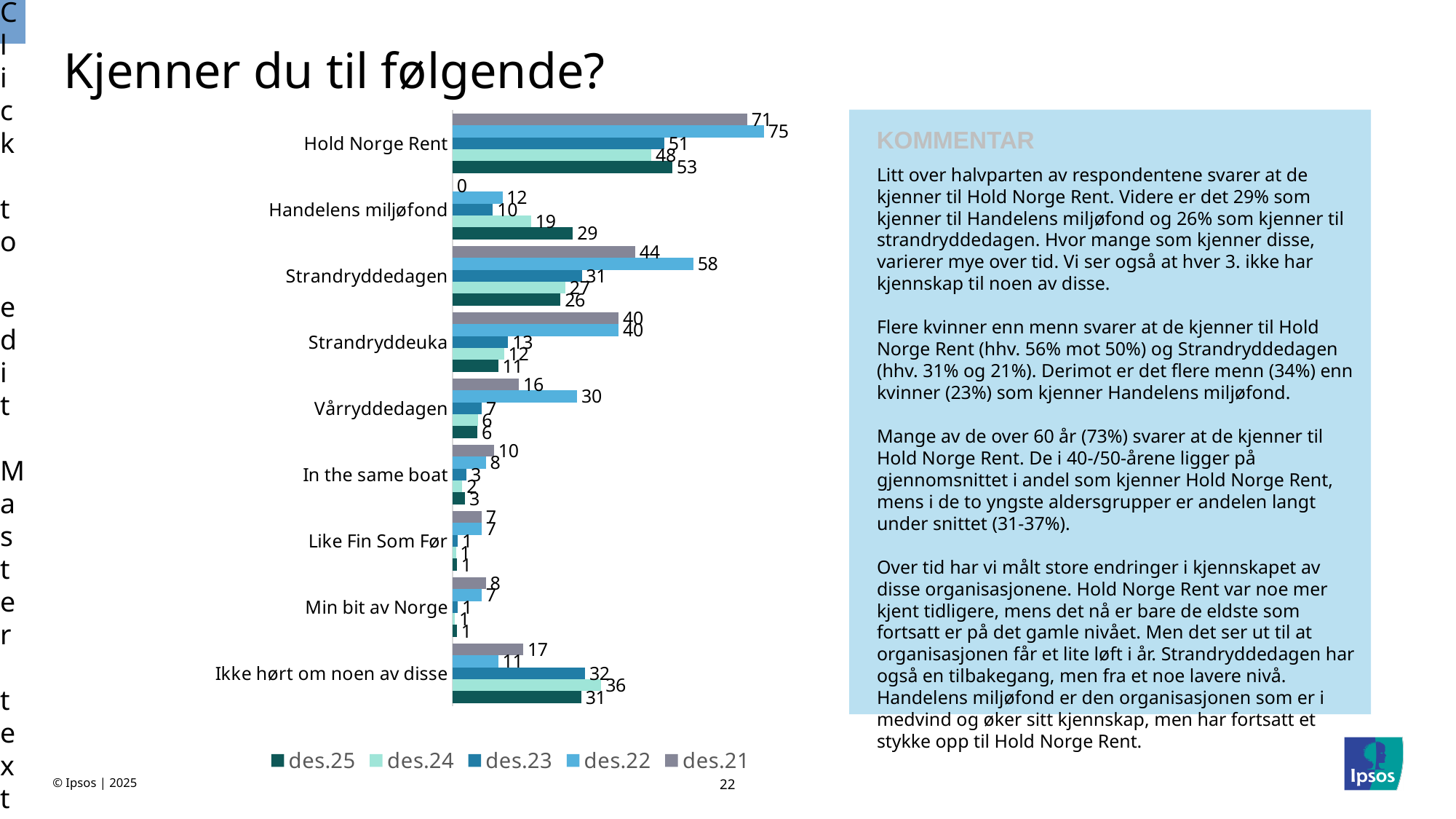
Which is larger for Strandryddedagen: the des.21 value or the des.23 value? des.21 What is the title of the slide? Kjenner du til følgende? Which category has the highest des.25 value? Hold Norge Rent How many series does the legend list? 5 What is the des.22 value for Strandryddedagen? 58 How many categories are shown on the chart? 9 What is the des.25 value for Handelens miljøfond? 29 What is the difference between the des.22 and des.25 values for Hold Norge Rent? 22 What kind of chart is shown on the slide? bar chart What is the des.24 value for Ikke hørt om noen av disse? 36 What is the des.25 value for Hold Norge Rent? 53